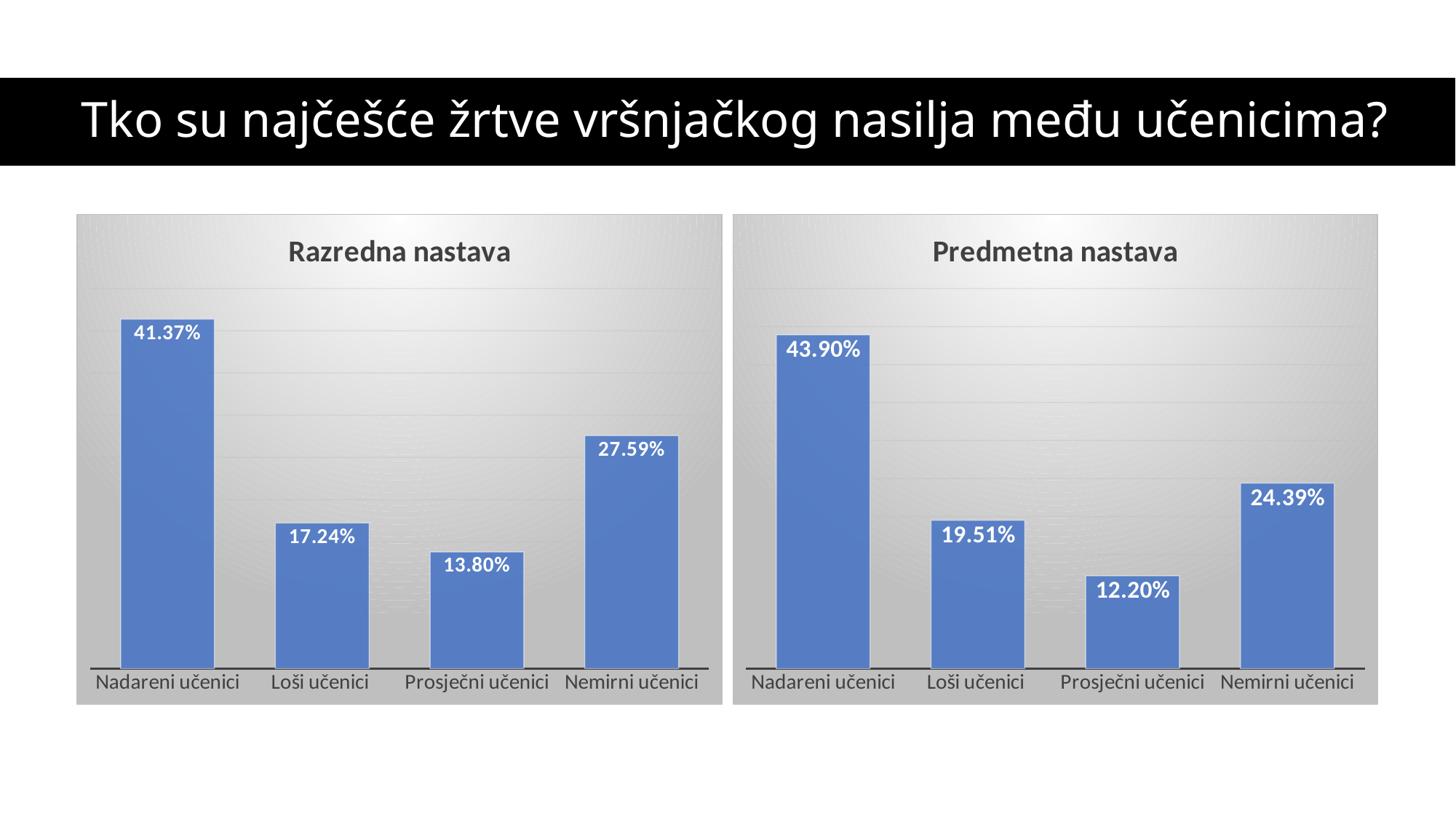
In the 'Razredna nastava' chart, which category has the highest value? Nadareni učenici In the 'Predmetna nastava' chart, what is the value for Prosječni učenici? 12.20% In the 'Predmetna nastava' chart, which category has the lowest value? Prosječni učenici How many categories are shown in the 'Razredna nastava' chart? 4 In the 'Predmetna nastava' chart, what is the difference between Nadareni učenici and Loši učenici? 24.39% In the 'Razredna nastava' chart, what is the value for Nadareni učenici? 41.37% In the 'Razredna nastava' chart, what is the value for Loši učenici? 17.24% In the 'Predmetna nastava' chart, which is larger: Loši učenici or Nemirni učenici? Nemirni učenici In the 'Razredna nastava' chart, what is the difference between Nemirni učenici and Prosječni učenici? 13.79% In the 'Predmetna nastava' chart, what is the value for Nemirni učenici? 24.39% What is the title of the chart on the left side of the slide? Razredna nastava What kind of chart is the 'Predmetna nastava' chart? Bar chart